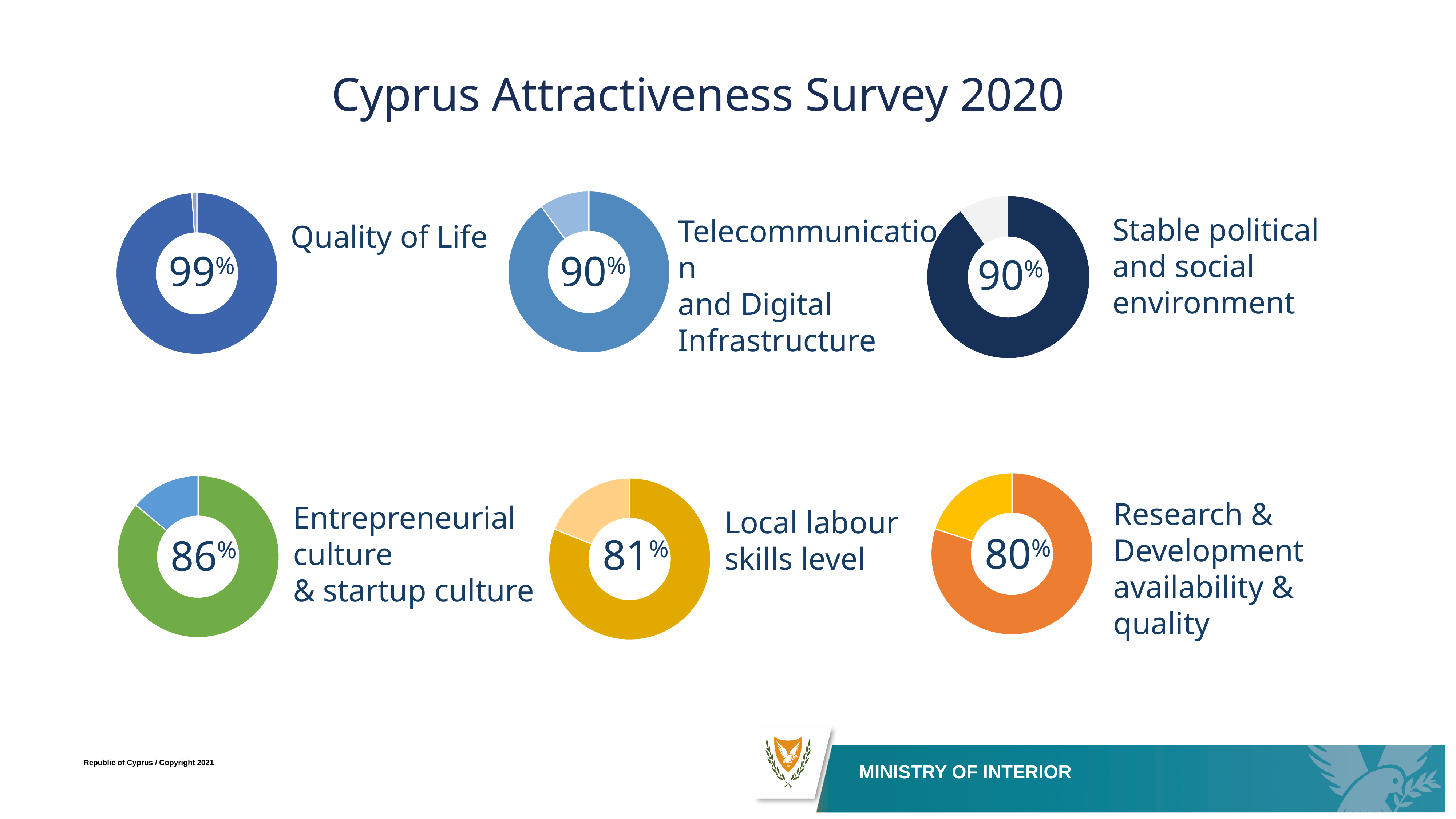
What is the difference between the Quality of Life percentage and the Local labour skills level percentage? 18% How many donut charts are shown on the slide? 6 What percentage is shown in the Quality of Life donut chart? 99% Which factor has the highest percentage on the slide? Quality of Life What percentage is shown for Local labour skills level? 81% What percentage is shown for Stable political and social environment? 90% Which factor has the lowest percentage on the slide? Research & Development availability & quality Which is larger, the percentage for Entrepreneurial culture & startup culture or for Research & Development availability & quality? Entrepreneurial culture & startup culture What percentage is shown for Entrepreneurial culture & startup culture? 86% What is the title of the slide containing the charts? Cyprus Attractiveness Survey 2020 What percentage is shown for Research & Development availability & quality? 80% What percentage is shown for Telecommunication and Digital Infrastructure? 90%